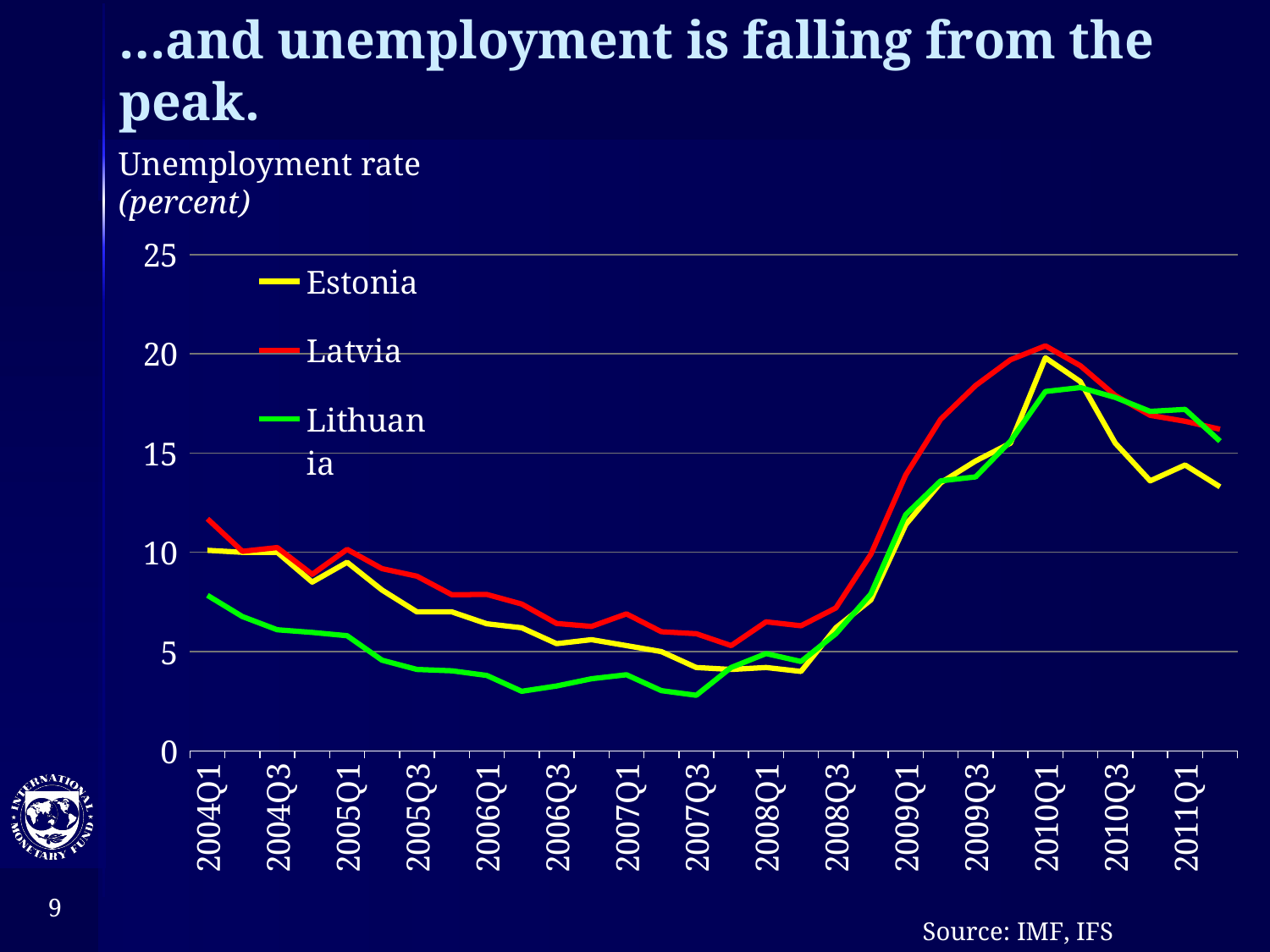
Which country has the lowest unemployment rate in 2007Q3? Lithuania How many series does the legend list? 3 Does the unemployment rate for Latvia rise or fall between 2008Q3 and 2010Q1? Rise In 2004Q1, which has the higher unemployment rate, Latvia or Lithuania? Latvia What kind of chart is shown on the slide? Line chart What colour is the line for Latvia? Red Is the unemployment rate for Latvia in 2004Q1 greater or less than 10? greater Which country's line reaches the highest peak on the chart? Latvia Which countries are listed in the chart legend? Estonia, Latvia, Lithuania Is the unemployment rate for Latvia in 2009Q1 greater or less than 15? less Is the unemployment rate for Lithuania in 2007Q3 greater or less than 5? less